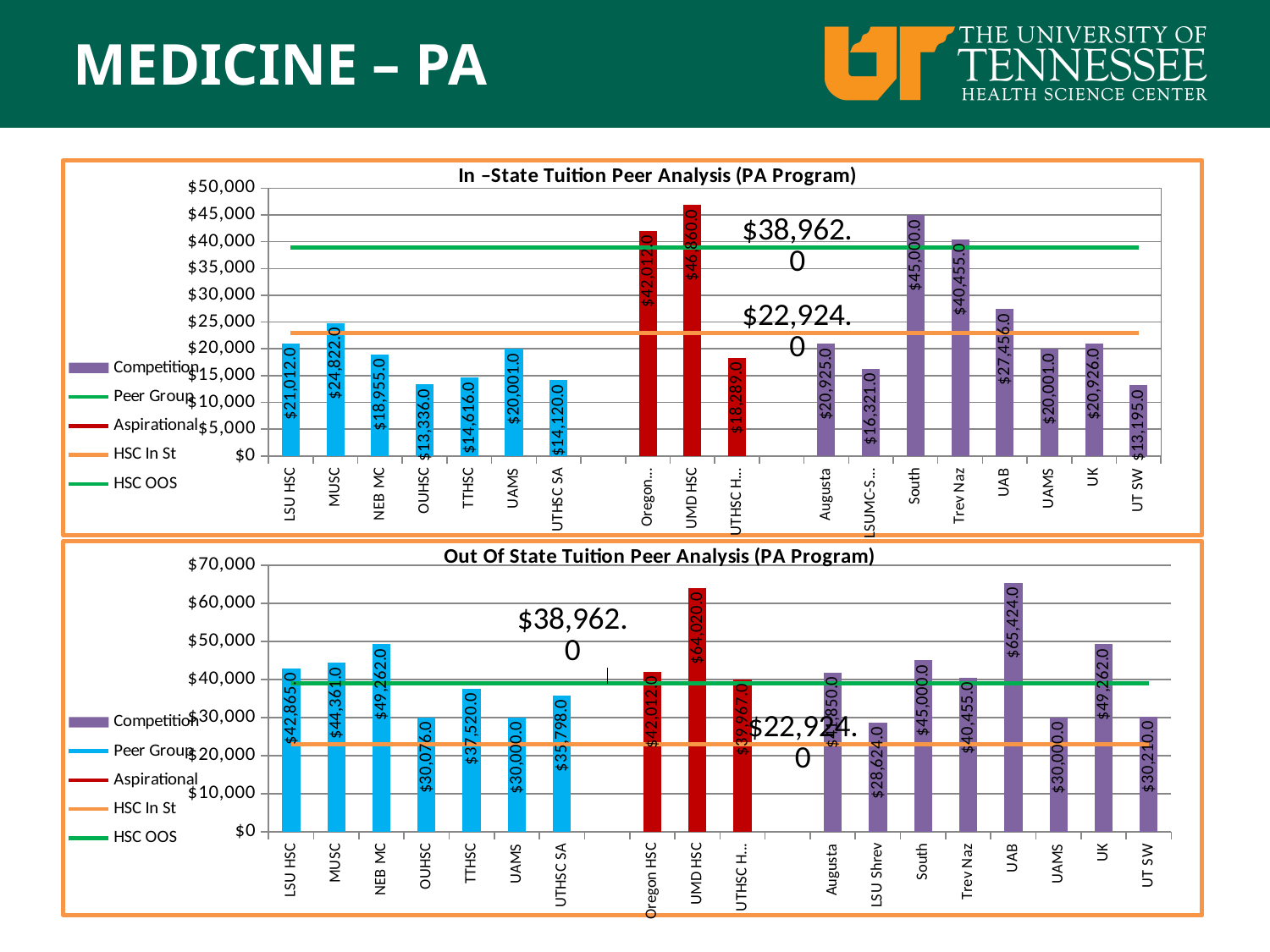
In the In-State Tuition Peer Analysis chart, what is the value for MUSC? $24,822.0 In the In-State Tuition Peer Analysis chart, what is the difference between UMD HSC and Oregon? $4,848.0 In the Out Of State Tuition Peer Analysis chart, what is the value for NEB MC? $49,262.0 In the In-State Tuition Peer Analysis chart, is the value for South greater or less than $40,000? greater In the Out Of State Tuition Peer Analysis chart, which institution has the highest tuition? UAB In the In-State Tuition Peer Analysis chart, which institution has the highest tuition? UMD HSC How many entries does the legend of the Out Of State Tuition Peer Analysis chart list? 5 In the In-State Tuition Peer Analysis chart, how many institutions are plotted as bars? 18 In the Out Of State Tuition Peer Analysis chart, what is the difference between UAB and UMD HSC? $1,404.0 In the In-State Tuition Peer Analysis chart, which is larger, MUSC or LSU HSC? MUSC What kind of chart is the In-State Tuition Peer Analysis chart? Bar chart In the Out Of State Tuition Peer Analysis chart, which institution has the lowest tuition? LSU Shrev